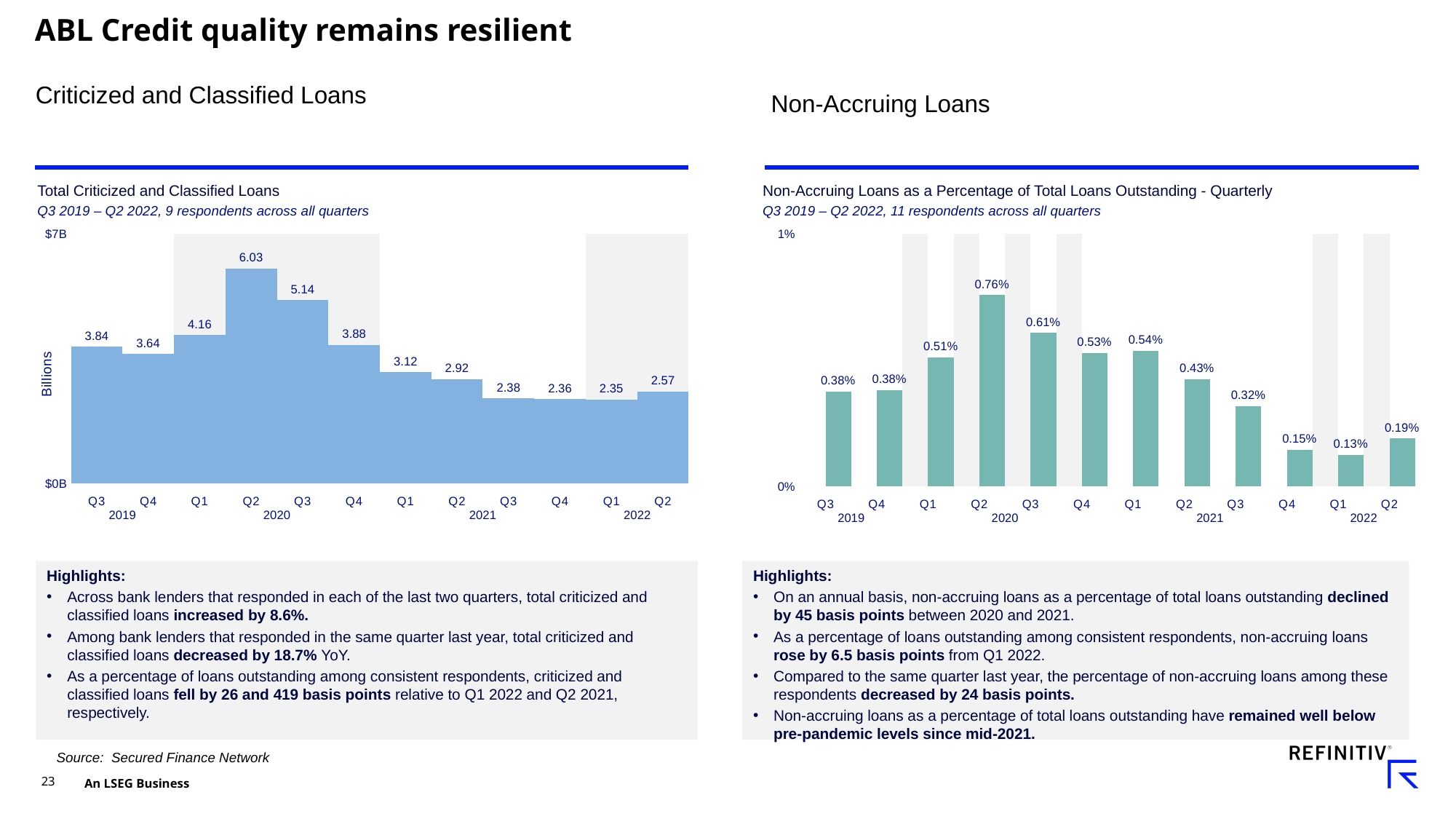
In the Total Criticized and Classified Loans chart, what is the value for Q2 2022? 2.57 In the Non-Accruing Loans chart, what is the difference between the Q3 2021 and Q4 2021 values? 0.17% In the Non-Accruing Loans chart, what is the value for Q2 2020? 0.76% In the Total Criticized and Classified Loans chart, which is larger, the value for Q3 2019 or Q4 2019? Q3 2019 In the Total Criticized and Classified Loans chart, how many quarters are plotted? 12 What kind of chart is the Non-Accruing Loans chart? Bar chart In the Total Criticized and Classified Loans chart, what is the value for Q2 2020? 6.03 In the Non-Accruing Loans chart, do the values rise or fall from Q2 2020 to Q1 2022? Fall In the Total Criticized and Classified Loans chart, what is the difference between the Q2 2020 and Q3 2020 values? 0.89 In the Non-Accruing Loans chart, how many respondents are noted in the subtitle? 11 In the Total Criticized and Classified Loans chart, which quarter has the lowest value? Q1 2022 In the Non-Accruing Loans chart, which quarter has the lowest value? Q1 2022